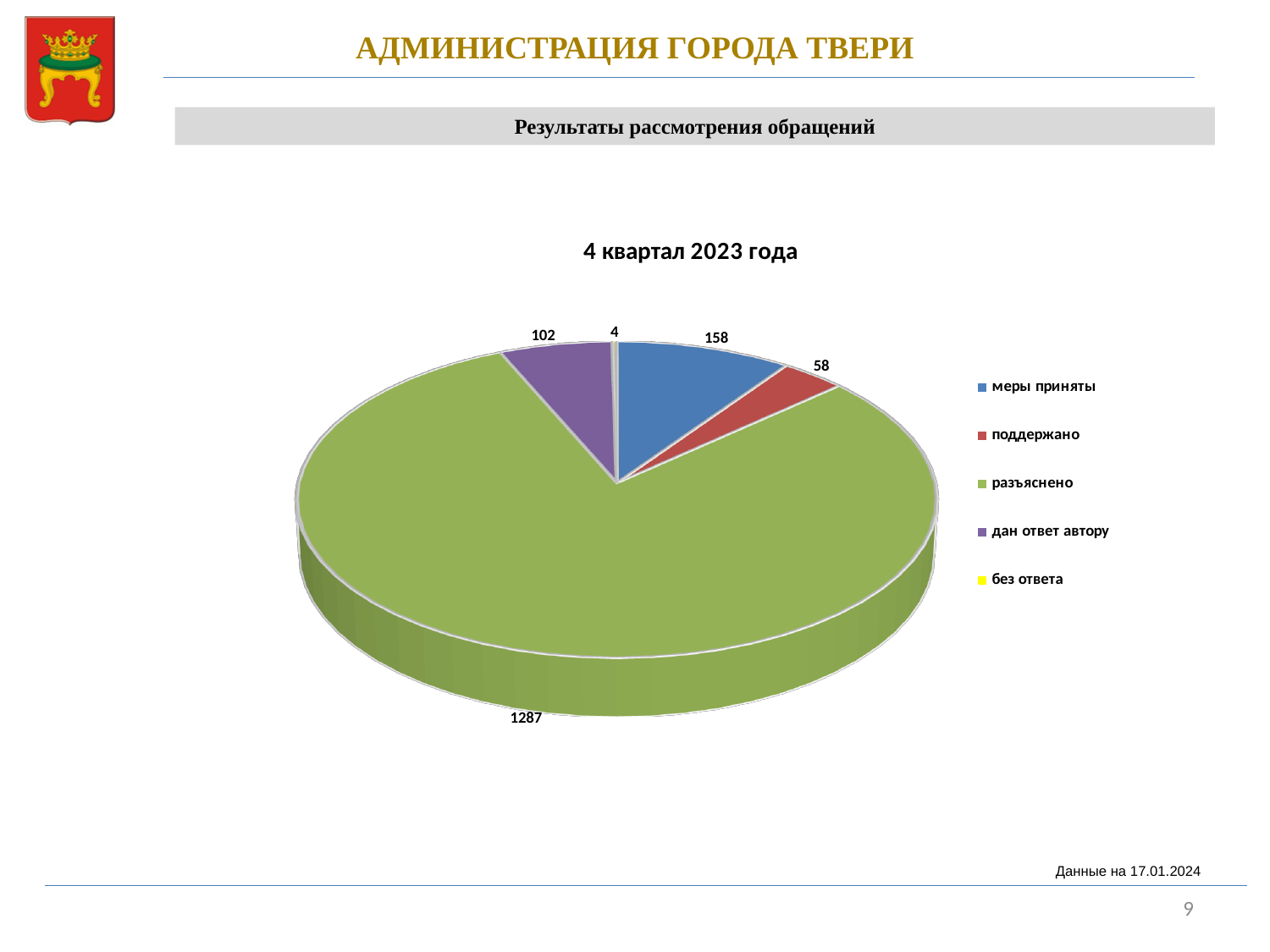
What kind of chart is shown on the slide? pie chart Which category has the smallest slice? без ответа What is the value for разъяснено? 1287 What is the value for поддержано? 58 What is the value for меры приняты? 158 Which is larger, the value for дан ответ автору or the value for поддержано? дан ответ автору How many series does the legend list? 5 What is the value for без ответа? 4 What is the value for дан ответ автору? 102 What is the difference between the values for меры приняты and поддержано? 100 Which category has the largest slice? разъяснено What is the title of the chart? 4 квартал 2023 года